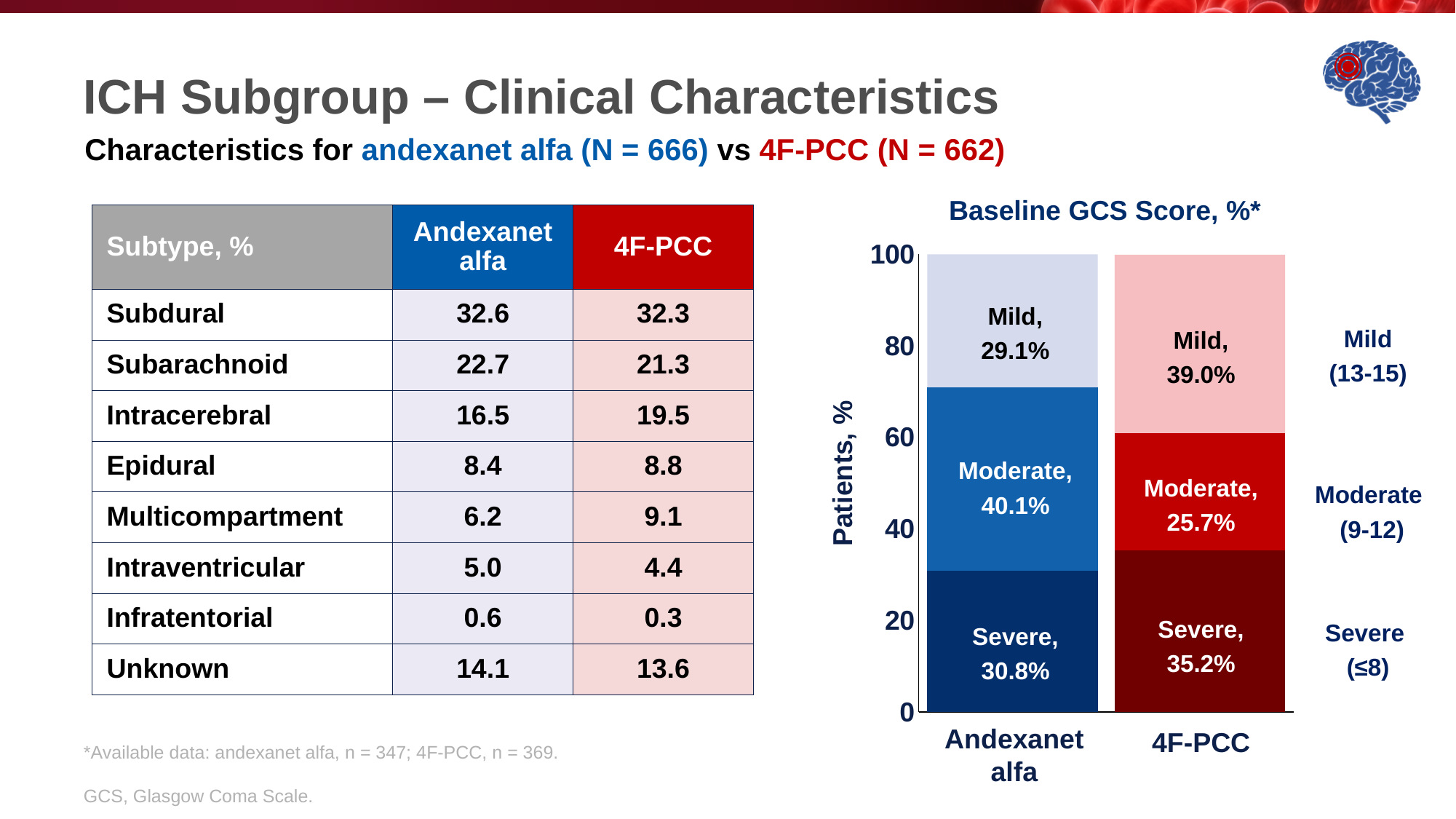
In the Baseline GCS Score chart, which GCS category is the smallest segment of the 4F-PCC bar? Moderate What is the label on the vertical axis of the Baseline GCS Score chart? Patients, % In the Baseline GCS Score chart, which GCS category is the largest segment of the andexanet alfa bar? Moderate In the Baseline GCS Score chart, which treatment group has the larger Severe percentage? 4F-PCC In the Baseline GCS Score chart, what percentage of 4F-PCC patients had a Severe GCS score? 35.2% In the Baseline GCS Score chart, what percentage of andexanet alfa patients had a Severe GCS score? 30.8% In the Baseline GCS Score chart, what is the difference in the Moderate percentage between andexanet alfa and 4F-PCC? 14.4 percentage points In the Baseline GCS Score chart, what is the difference in the Mild percentage between 4F-PCC and andexanet alfa? 9.9 percentage points In the Baseline GCS Score chart, what percentage of andexanet alfa patients had a Moderate GCS score? 40.1% What type of chart is shown under the title "Baseline GCS Score, %*"? Stacked bar chart How many bars are shown in the Baseline GCS Score chart? 2 In the Baseline GCS Score chart, what percentage of 4F-PCC patients had a Mild GCS score? 39.0%